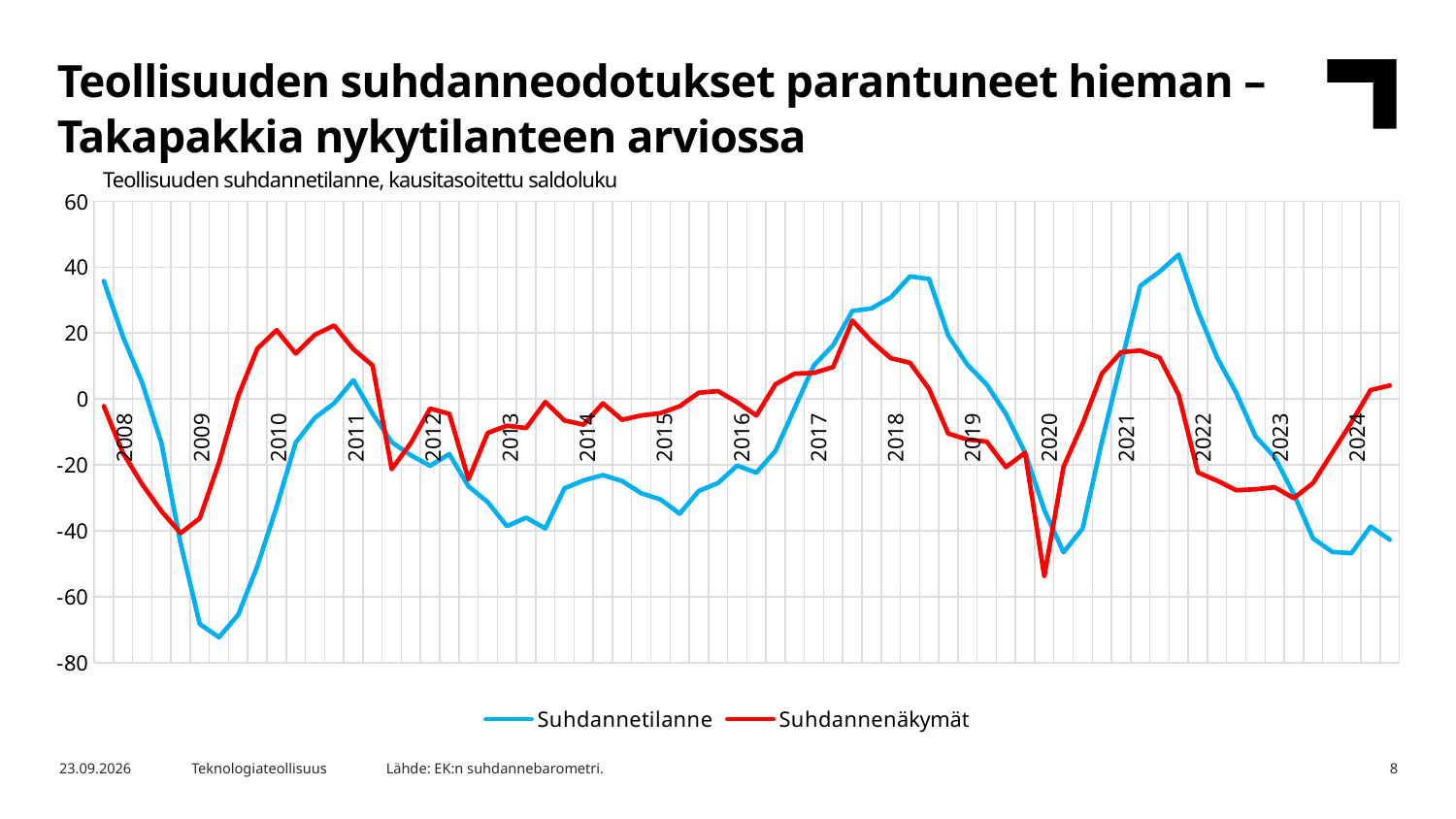
How many series does the legend list? 2 What is the subtitle printed above the chart? Teollisuuden suhdannetilanne, kausitasoitettu saldoluku Is the Suhdannetilanne value at the start of 2008 greater or less than 20? greater What are the two series named in the legend? Suhdannetilanne and Suhdannenäkymät In 2013, which series is higher, Suhdannetilanne or Suhdannenäkymät? Suhdannenäkymät Is the lowest value of the Suhdannetilanne line, reached in 2009, greater or less than -60? less Which series reaches the lowest value anywhere on the chart? Suhdannetilanne Which series reaches the highest value anywhere on the chart? Suhdannetilanne What kind of chart is shown on the slide? line chart Is the lowest value of the Suhdannenäkymät line in 2020 greater or less than -40? less